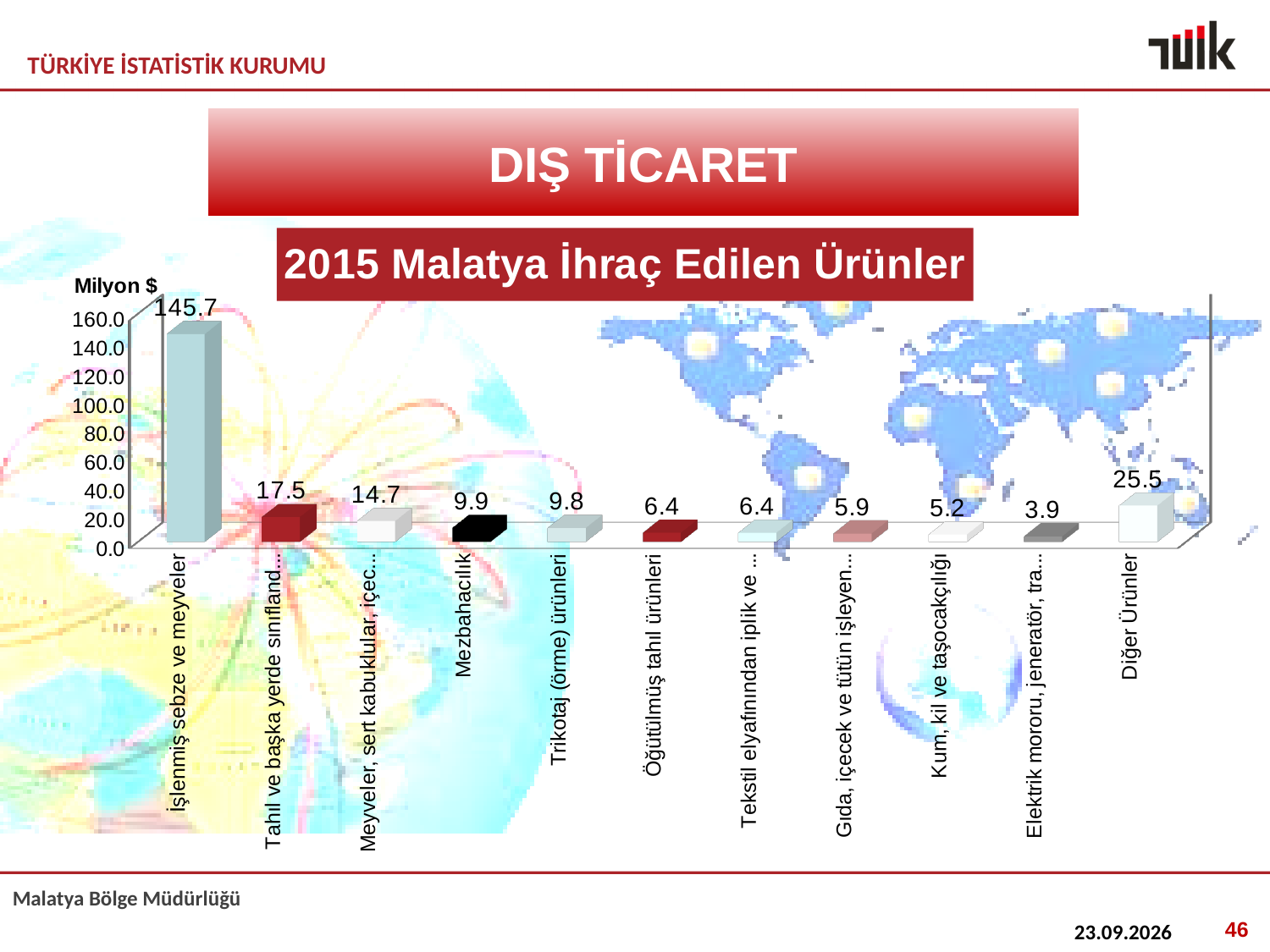
What is the value for Trikotaj (örme) ürünleri? 9.8 What is the value for Diğer Ürünler? 25.5 How many categories are shown on the chart? 11 What is the difference between the values for İşlenmiş sebze ve meyveler and Diğer Ürünler? 120.2 What is the value for Mezbahacılık? 9.9 Which is larger, the value for Mezbahacılık or the value for Öğütülmüş tahıl ürünleri? Mezbahacılık What kind of chart is shown on the slide? Bar chart What is the value for Kum, kil ve taşocakçılığı? 5.2 Which category has the highest value? İşlenmiş sebze ve meyveler What is the value for İşlenmiş sebze ve meyveler? 145.7 What is the lowest value shown on the chart? 3.9 What unit is shown above the vertical axis of the chart? Milyon $